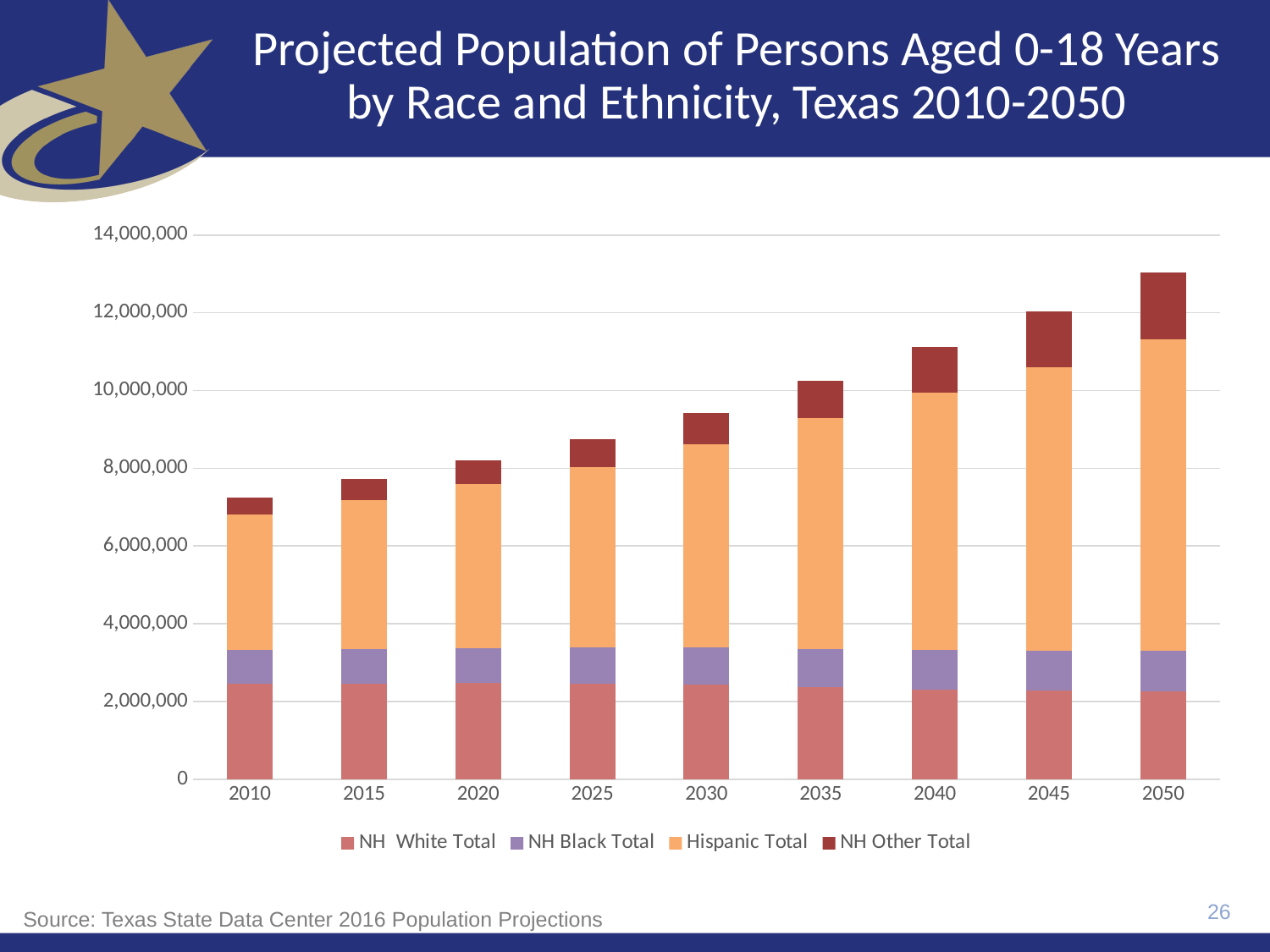
Which series in the legend is shown in orange? Hispanic Total How many years are shown along the x axis of the chart? 9 How many series does the chart's legend list? 4 Is the total projected population for 2010 greater or less than 8,000,000? less Which is larger, the total bar for 2050 or the total bar for 2010? 2050 What kind of chart is shown on the slide? Stacked bar chart Is the total projected population for 2040 greater or less than 10,000,000? greater What is the title of the chart on the slide? Projected Population of Persons Aged 0-18 Years by Race and Ethnicity, Texas 2010-2050 Which year has the shortest stacked bar in the chart? 2010 Which year has the tallest stacked bar in the chart? 2050 Is the total projected population for 2050 greater or less than 12,000,000? greater Do the total bar heights rise or fall from 2010 to 2050? Rise